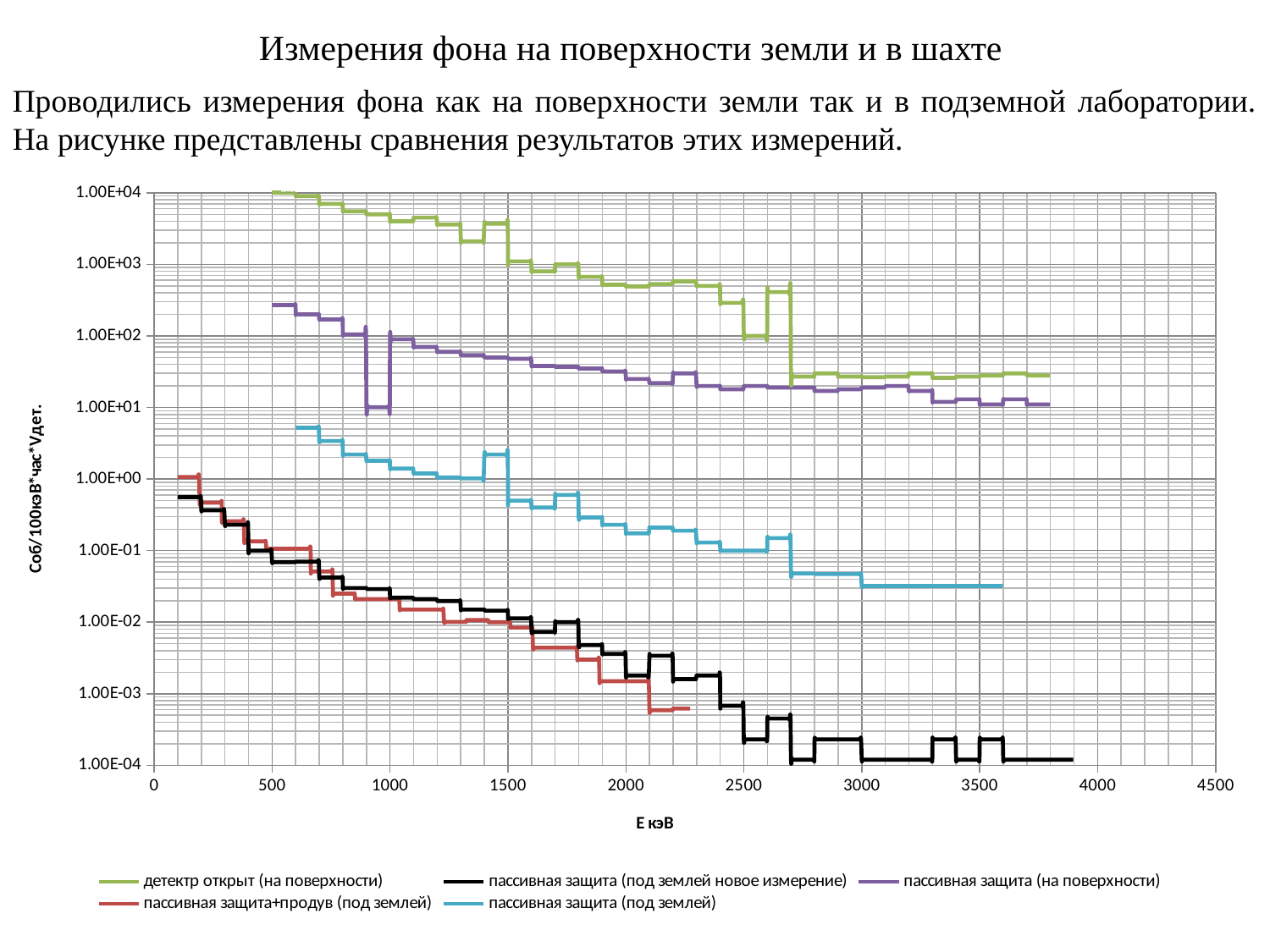
At E = 1000 кэВ, which series is higher: "детектор открыт (на поверхности)" or "пассивная защита (на поверхности)"? детектор открыт (на поверхности) Do the values of the series "детектор открыт (на поверхности)" rise or fall as E increases along the x axis? fall Is the value of "детектор открыт (на поверхности)" at E = 2000 кэВ greater or less than 1.00E+03? less What kind of chart is shown on the slide? line chart At E = 2000 кэВ, which series is higher: "пассивная защита (под землей)" or "пассивная защита (под землей новое измерение)"? пассивная защита (под землей) How many series does the legend list? 5 Is the value of "пассивная защита (на поверхности)" at E = 500 кэВ greater or less than 1.00E+02? greater Is the value of "пассивная защита (под землей новое измерение)" at E = 2500 кэВ greater or less than 1.00E-03? less Which series has the highest values across the chart? детектор открыт (на поверхности) What is the label of the x axis? E кэВ What colour is the line for "пассивная защита+продув (под землей)"? red